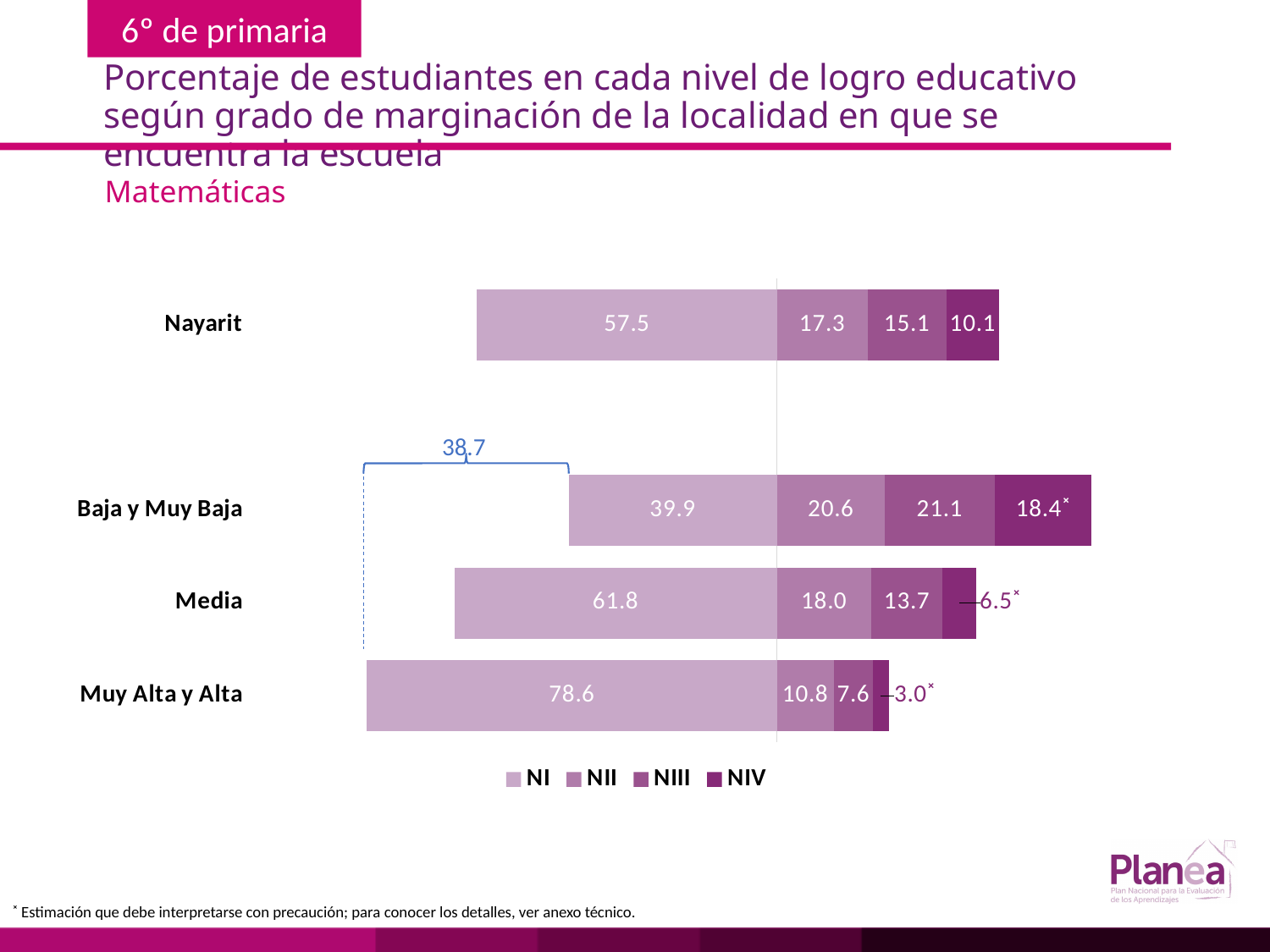
What is the NI value for Nayarit? 57.5 Which category has the highest NI value? Muy Alta y Alta What is the difference between the NI values for Muy Alta y Alta and Baja y Muy Baja? 38.7 Which category has the lowest NI value? Baja y Muy Baja How many series does the legend list? 4 Which has the larger NIII value, Baja y Muy Baja or Nayarit? Baja y Muy Baja What is the total of the stacked bar for Nayarit? 100.0 What is the NIII value for Muy Alta y Alta? 7.6 What kind of chart is shown on the slide? Stacked bar chart What is the NIV value for Baja y Muy Baja? 18.4* What is the NII value for Media? 18.0 How many categories are shown on the chart? 4